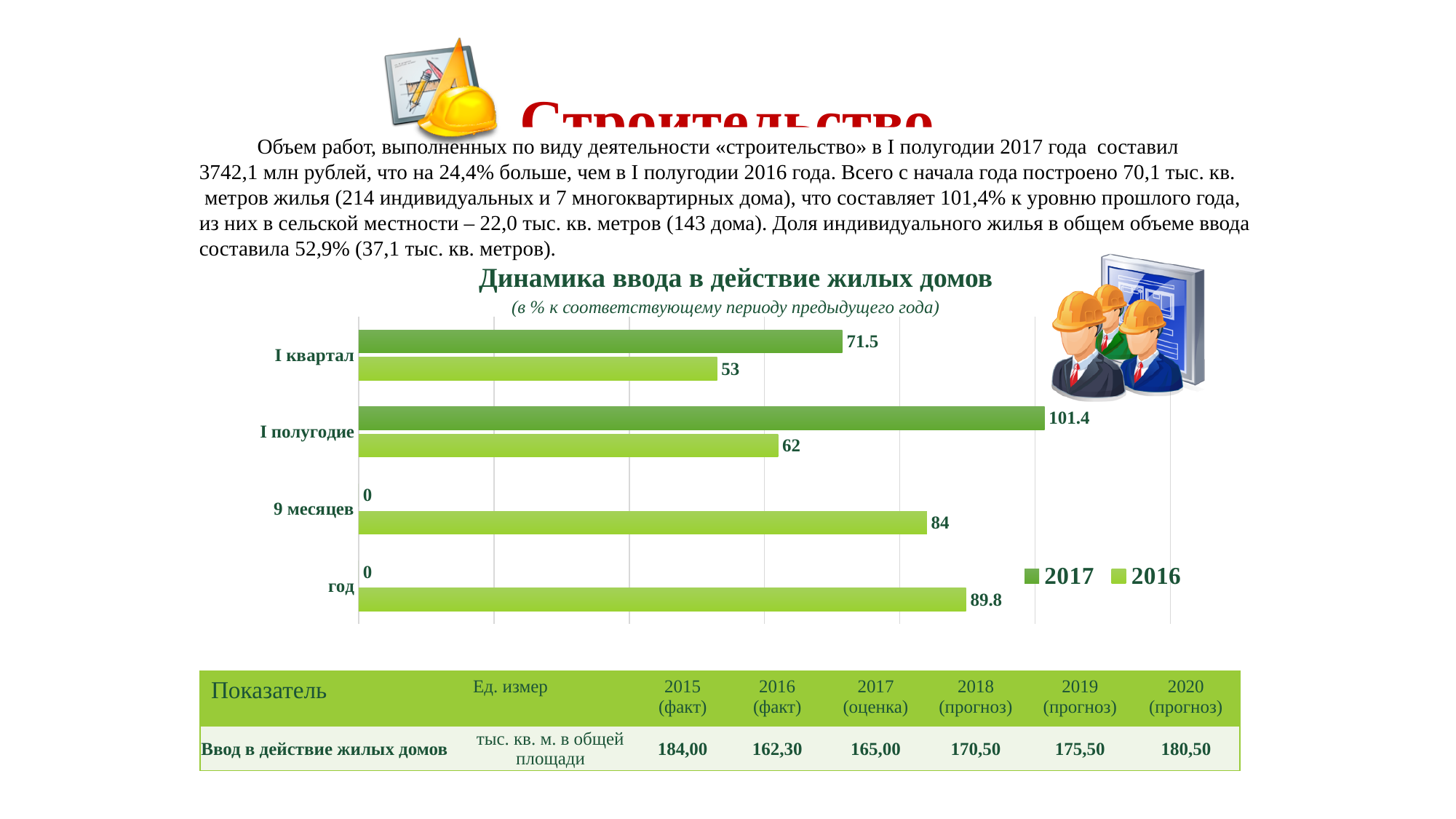
Which is larger in the I квартал category: the 2017 value or the 2016 value? 2017 What is the value for 2017 in the I полугодие category? 101.4 What is the difference between the 2017 and 2016 values in the I полугодие category? 39.4 How many categories are shown on the chart? 4 What is the title of the chart? Динамика ввода в действие жилых домов What kind of chart is shown on the slide? Bar chart Which category has the lowest value for the 2016 series? I квартал What is the value for 2016 in the 9 месяцев category? 84 What is the value for 2016 in the I квартал category? 53 What is the value for 2016 in the год category? 89.8 Which category has the highest value for the 2016 series? год How many series does the legend list? 2